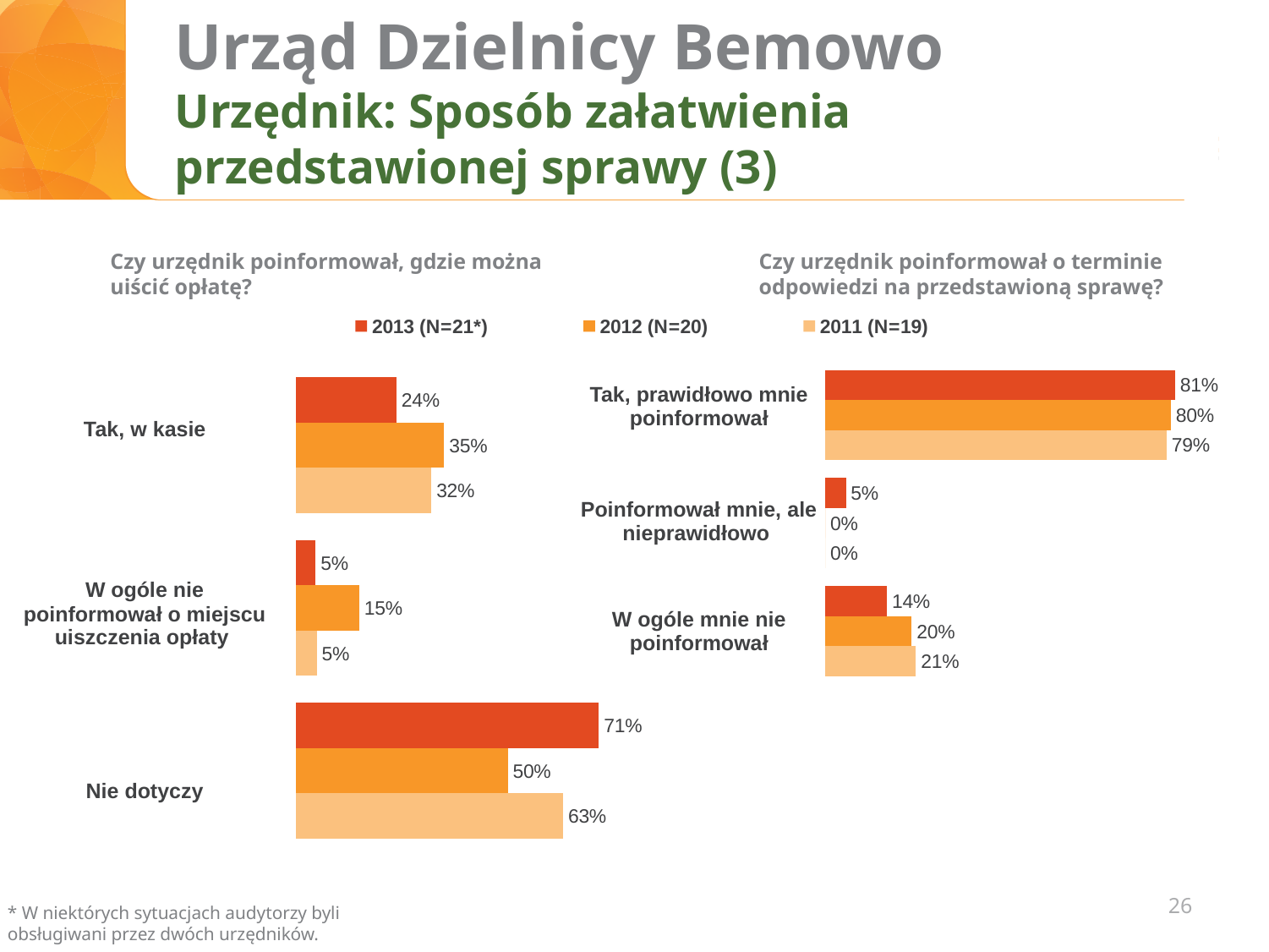
In the left chart (Czy urzędnik poinformował, gdzie można uiścić opłatę?), what is the difference between the 2013 (N=21*) and 2012 (N=20) values for 'Nie dotyczy'? 21 percentage points In the left chart (Czy urzędnik poinformował, gdzie można uiścić opłatę?), what is the value for 'Nie dotyczy' in 2013 (N=21*)? 71% In the right chart (Czy urzędnik poinformował o terminie odpowiedzi na przedstawioną sprawę?), which category has the lowest value for 2013 (N=21*)? Poinformował mnie, ale nieprawidłowo In the right chart (Czy urzędnik poinformował o terminie odpowiedzi na przedstawioną sprawę?), what is the value for 'Poinformował mnie, ale nieprawidłowo' in 2012 (N=20)? 0% In the left chart (Czy urzędnik poinformował, gdzie można uiścić opłatę?), which is larger for 'Tak, w kasie': the 2012 (N=20) value or the 2011 (N=19) value? 2012 (N=20) In the right chart (Czy urzędnik poinformował o terminie odpowiedzi na przedstawioną sprawę?), what is the value for 'W ogóle mnie nie poinformował' in 2011 (N=19)? 21% In the left chart (Czy urzędnik poinformował, gdzie można uiścić opłatę?), which category has the highest value for 2013 (N=21*)? Nie dotyczy How many categories does the right chart (Czy urzędnik poinformował o terminie odpowiedzi na przedstawioną sprawę?) show? 3 What kind of chart is the left chart (Czy urzędnik poinformował, gdzie można uiścić opłatę?)? Bar chart In the right chart (Czy urzędnik poinformował o terminie odpowiedzi na przedstawioną sprawę?), what is the difference between the 2011 (N=19) and 2013 (N=21*) values for 'W ogóle mnie nie poinformował'? 7 percentage points How many series does the legend list? 3 In the left chart (Czy urzędnik poinformował, gdzie można uiścić opłatę?), what is the value for 'Tak, w kasie' in 2012 (N=20)? 35%